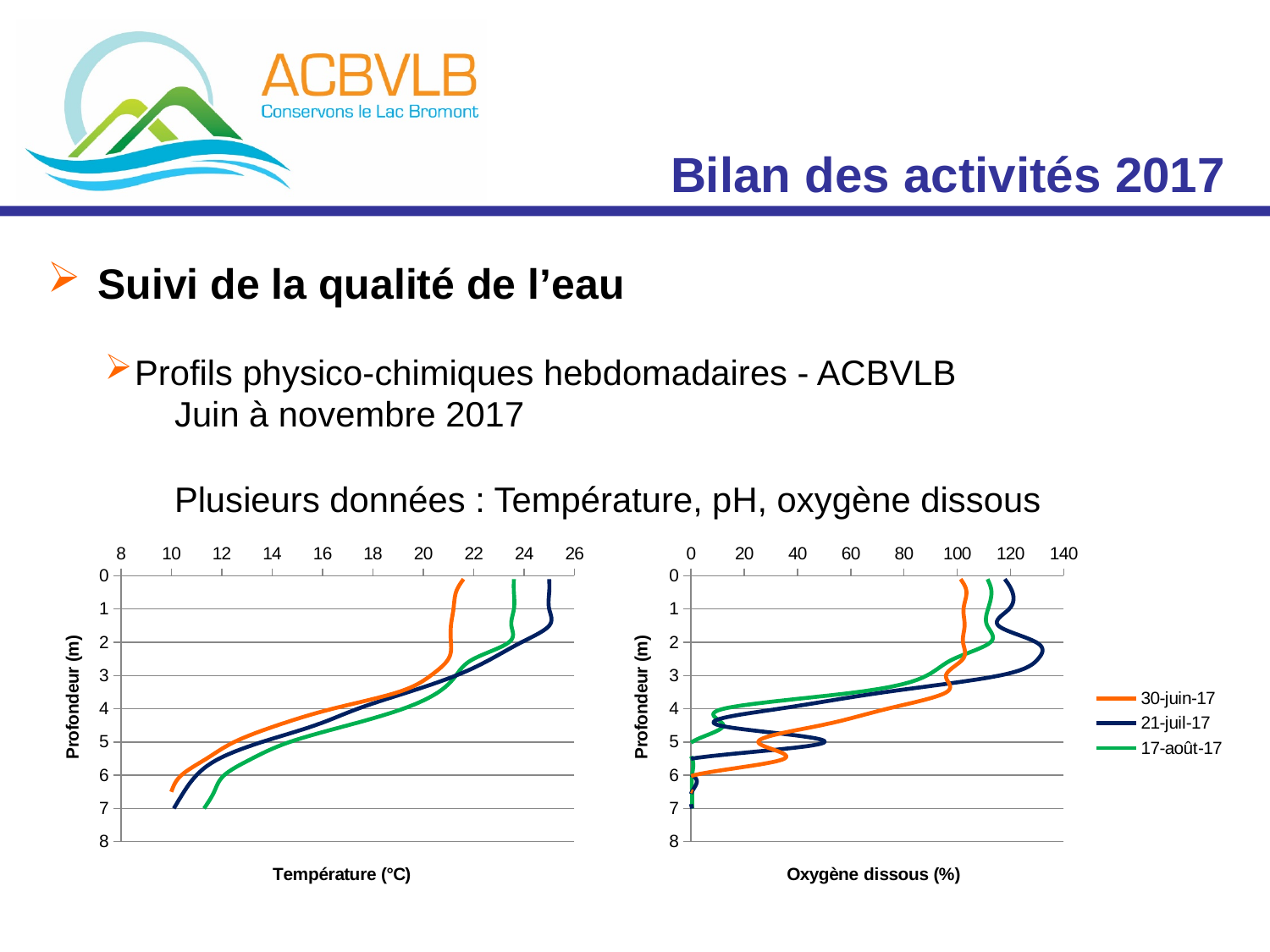
In the Oxygène dissous (%) chart, is the value for 21-juil-17 at depth 2 m greater or less than 120? greater In the Température (°C) chart, does the temperature rise or fall as depth increases from 0 m to 7 m? fall What kind of chart is the Température (°C) chart on the left? line chart How many series does the legend list for the charts? 3 In the Température (°C) chart, is the temperature for 30-juin-17 at depth 0 m greater or less than 20? greater In the Oxygène dissous (%) chart, which series has the higher value at depth 2 m, 21-juil-17 or 30-juin-17? 21-juil-17 What is the label of the vertical axis on the Oxygène dissous (%) chart? Profondeur (m) In the Température (°C) chart, is the temperature for 21-juil-17 at depth 0 m greater or less than 24? greater In the Température (°C) chart, which series has the higher temperature at depth 0 m, 21-juil-17 or 30-juin-17? 21-juil-17